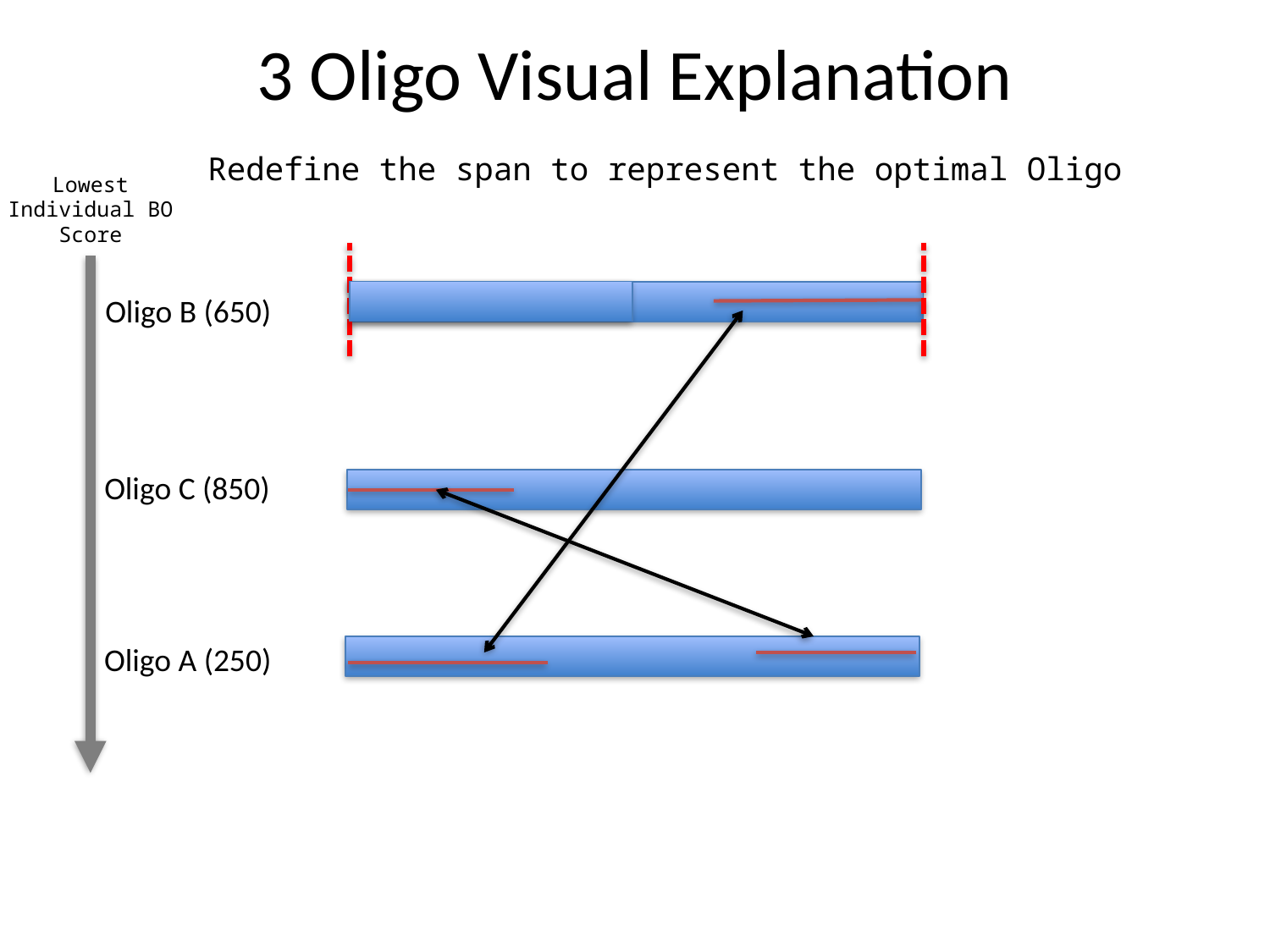
What score is shown in parentheses for Oligo A? 250 What score is shown in parentheses for Oligo B? 650 Which oligo has the highest score shown in parentheses? Oligo C Which oligo has the lowest score shown in parentheses? Oligo A What is the difference between the scores of Oligo C and Oligo A? 600 How many oligos are shown as bars on the slide? 3 What does the label next to the vertical grey arrow on the left say? Lowest Individual BO Score What is the difference between the scores of Oligo C and Oligo B? 200 Which has the larger score, Oligo B or Oligo A? Oligo B What is the title of the slide? 3 Oligo Visual Explanation What score is shown in parentheses for Oligo C? 850